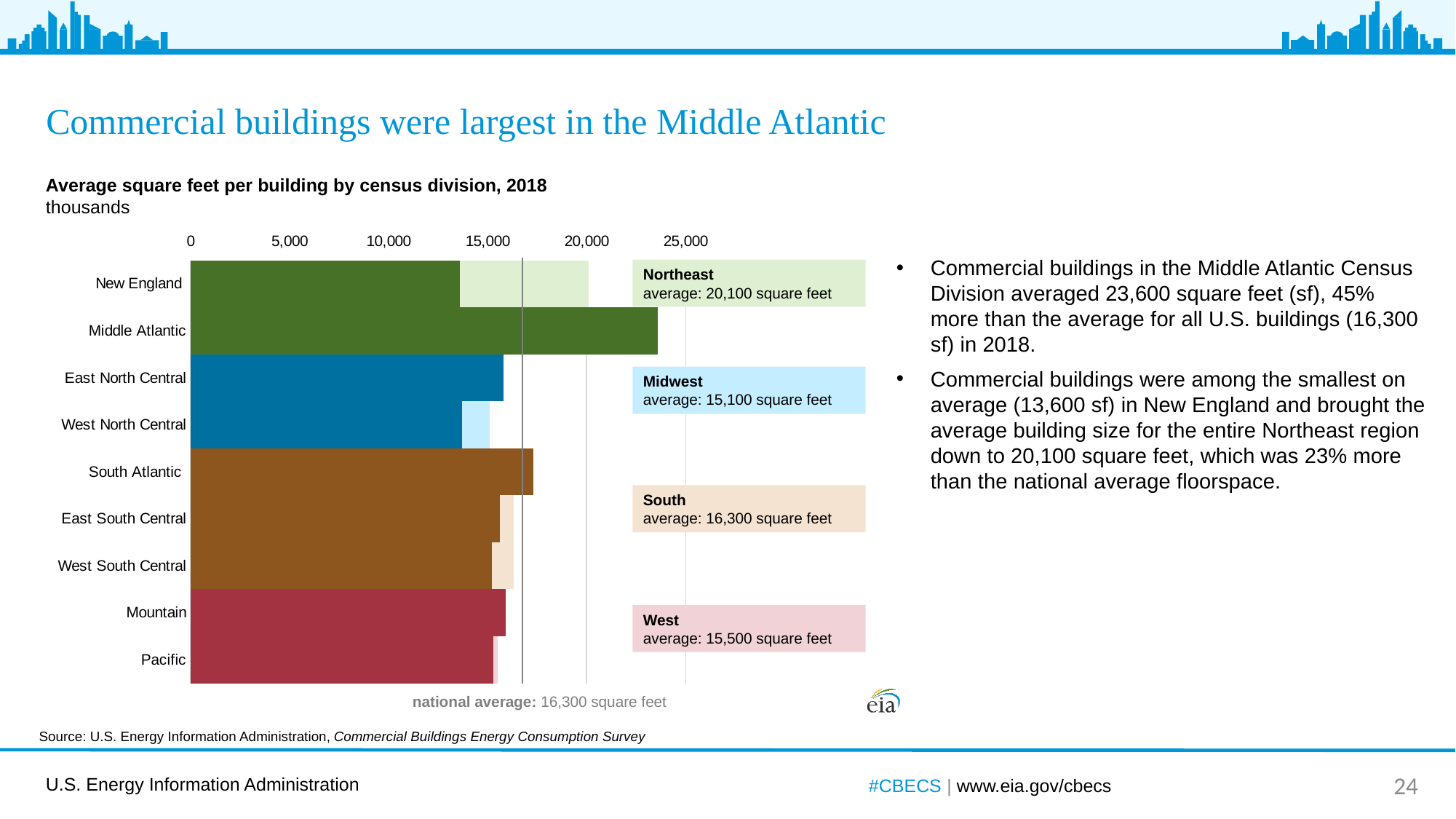
Is the value for Middle Atlantic greater or less than 20,000? greater What kind of chart is shown on the slide? bar chart What national average is marked on the chart? 16,300 square feet What is the average square feet per building for the Midwest region shown in the chart? 15,100 square feet Is the value for New England greater or less than 15,000? less What is the average square feet per building for the West region shown in the chart? 15,500 square feet What is the title of the chart? Average square feet per building by census division, 2018 Which regional average is larger, the South or the West? South Which census division has the largest average square feet per building? Middle Atlantic How many census divisions are plotted in the chart? 9 What is the difference between the Northeast regional average and the Midwest regional average? 5,000 square feet What is the average square feet per building for the Northeast region shown in the chart? 20,100 square feet